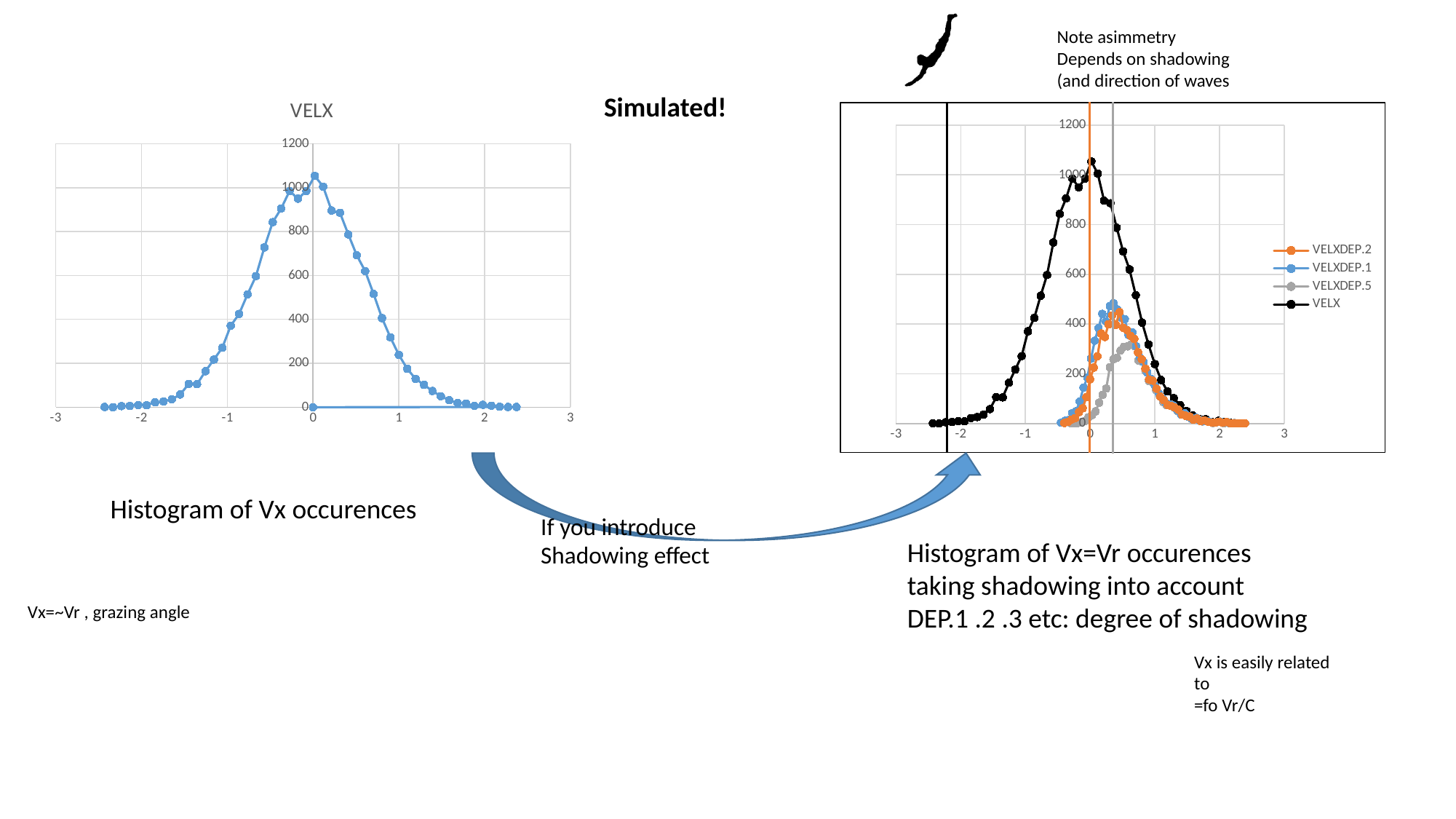
In the right chart, which series reaches the highest peak value? VELX What kind of chart is the left chart titled VELX? line chart In the right chart, is the peak value of VELXDEP.5 greater or less than 400? less What is the title of the left chart? VELX In the right chart, which series has a higher peak, VELX or VELXDEP.5? VELX In the right chart, which series is drawn in black? VELX In the left chart, is the peak value of VELX greater or less than 800? greater How many series does the legend of the right chart list? 4 In the left chart, do the VELX values rise or fall as x goes from 0 to 2? fall In the right chart, which series has the lowest peak value? VELXDEP.5 In the right chart, is the value of VELX at x = -2 greater or less than 200? less In the left chart, do the VELX values rise or fall as x goes from -2 to 0? rise